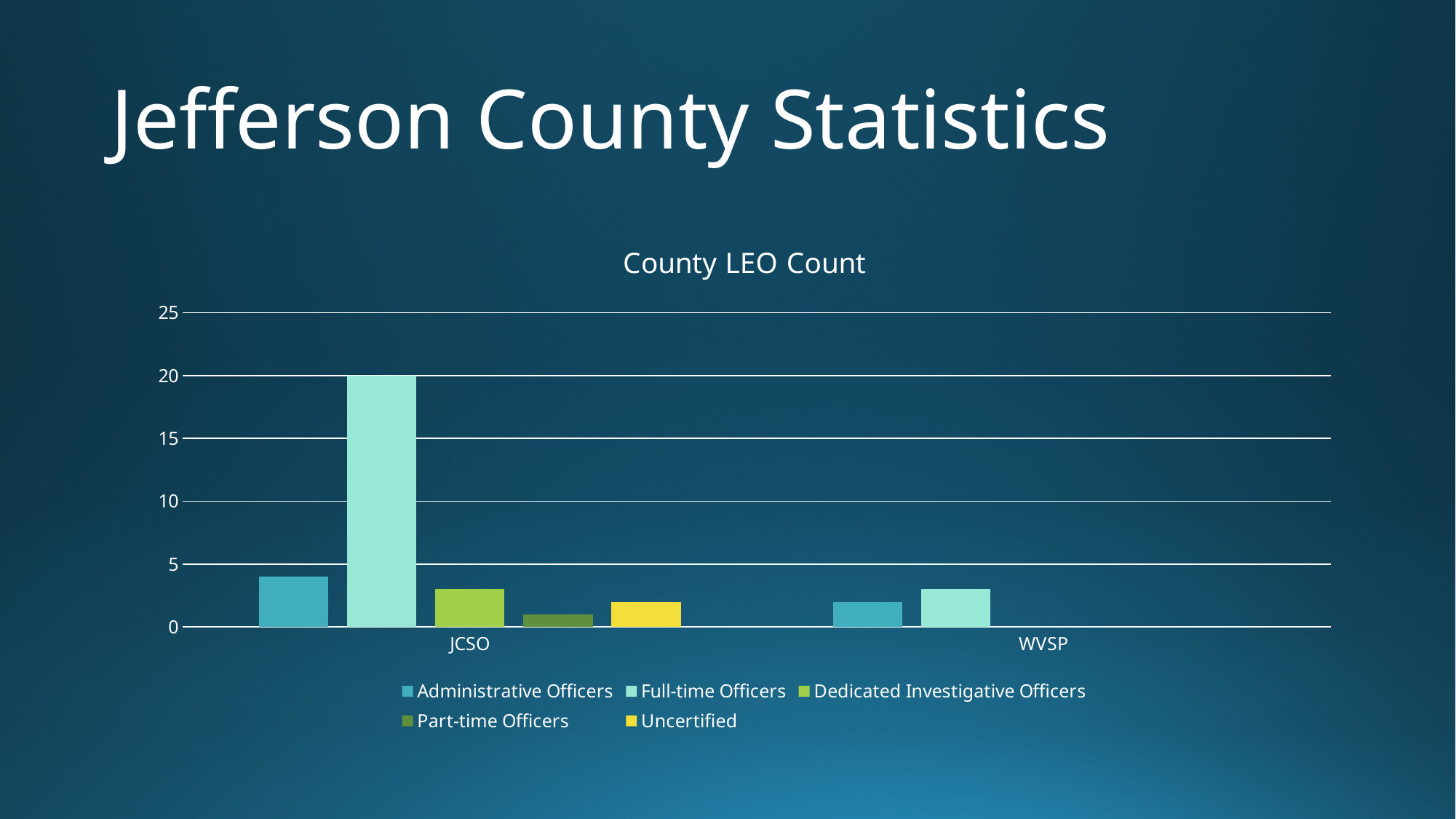
How many categories are shown on the x axis? 2 Which series has the lowest visible bar for JCSO? Part-time Officers Which is larger for JCSO: Administrative Officers or Part-time Officers? Administrative Officers Which is larger: Full-time Officers at JCSO or Full-time Officers at WVSP? Full-time Officers at JCSO What is the value for Full-time Officers at JCSO? 20 Which category has the taller Administrative Officers bar, JCSO or WVSP? JCSO Is the value for Full-time Officers at WVSP greater or less than 5? less Is the value for Administrative Officers at JCSO greater or less than 5? less How many series does the legend list? 5 What kind of chart is shown on the slide? bar chart Which series has the highest value for JCSO? Full-time Officers What is the title of the chart? County LEO Count